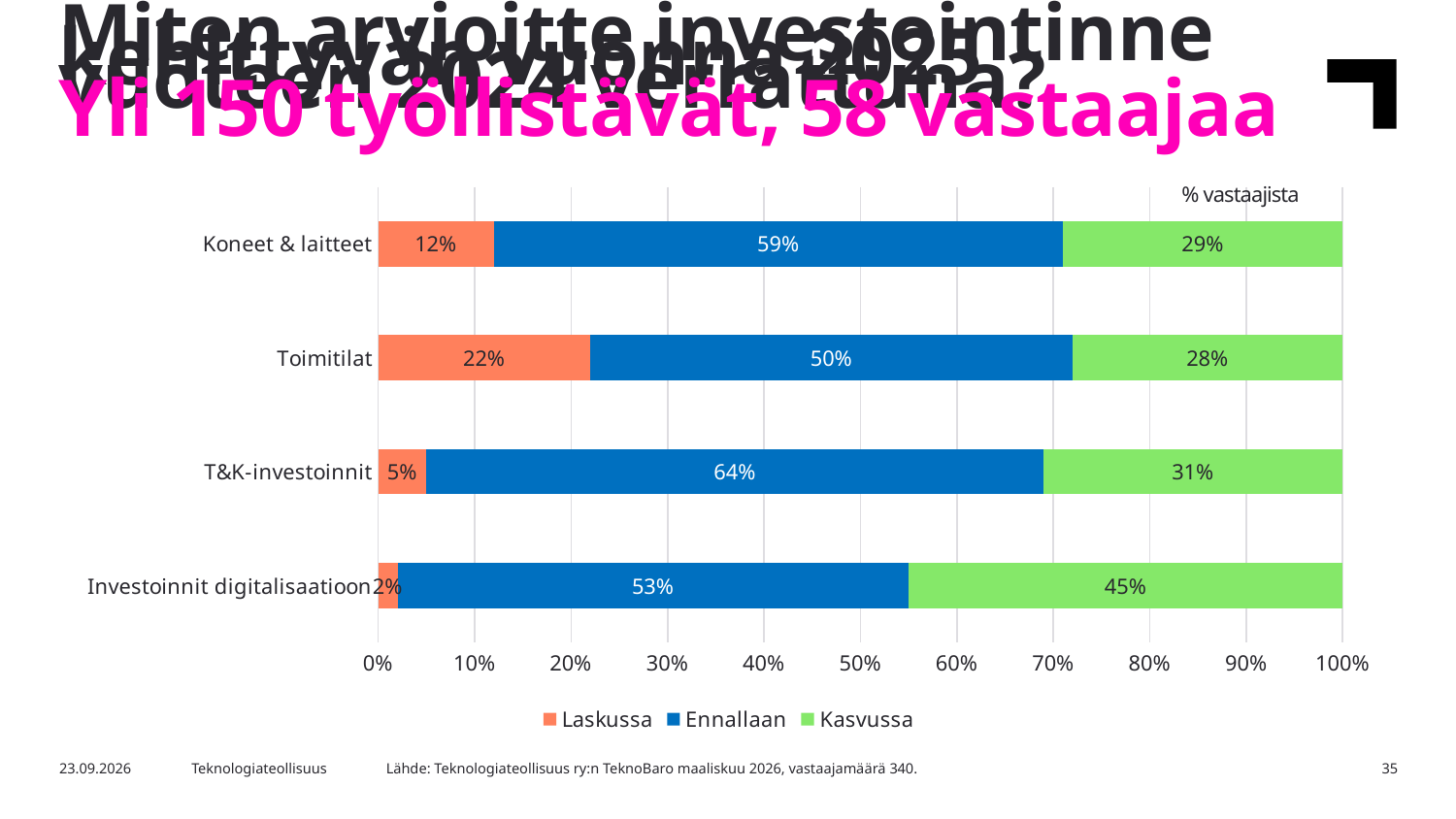
What is the Laskussa value for Toimitilat? 22% What is the Kasvussa value for Investoinnit digitalisaatioon? 45% What kind of chart is shown on the slide? Stacked bar chart Which category has the highest Kasvussa value? Investoinnit digitalisaatioon What is the difference between the Ennallaan values for T&K-investoinnit and Toimitilat? 14% What is the total of the stacked bar for Koneet & laitteet? 100% How many categories are shown on the chart? 4 Which category has the lowest Laskussa value? Investoinnit digitalisaatioon What is the Ennallaan value for T&K-investoinnit? 64% Which is larger, the Kasvussa value for Koneet & laitteet or for Toimitilat? Koneet & laitteet How many series does the legend list? 3 Which series is shown in green in the legend? Kasvussa